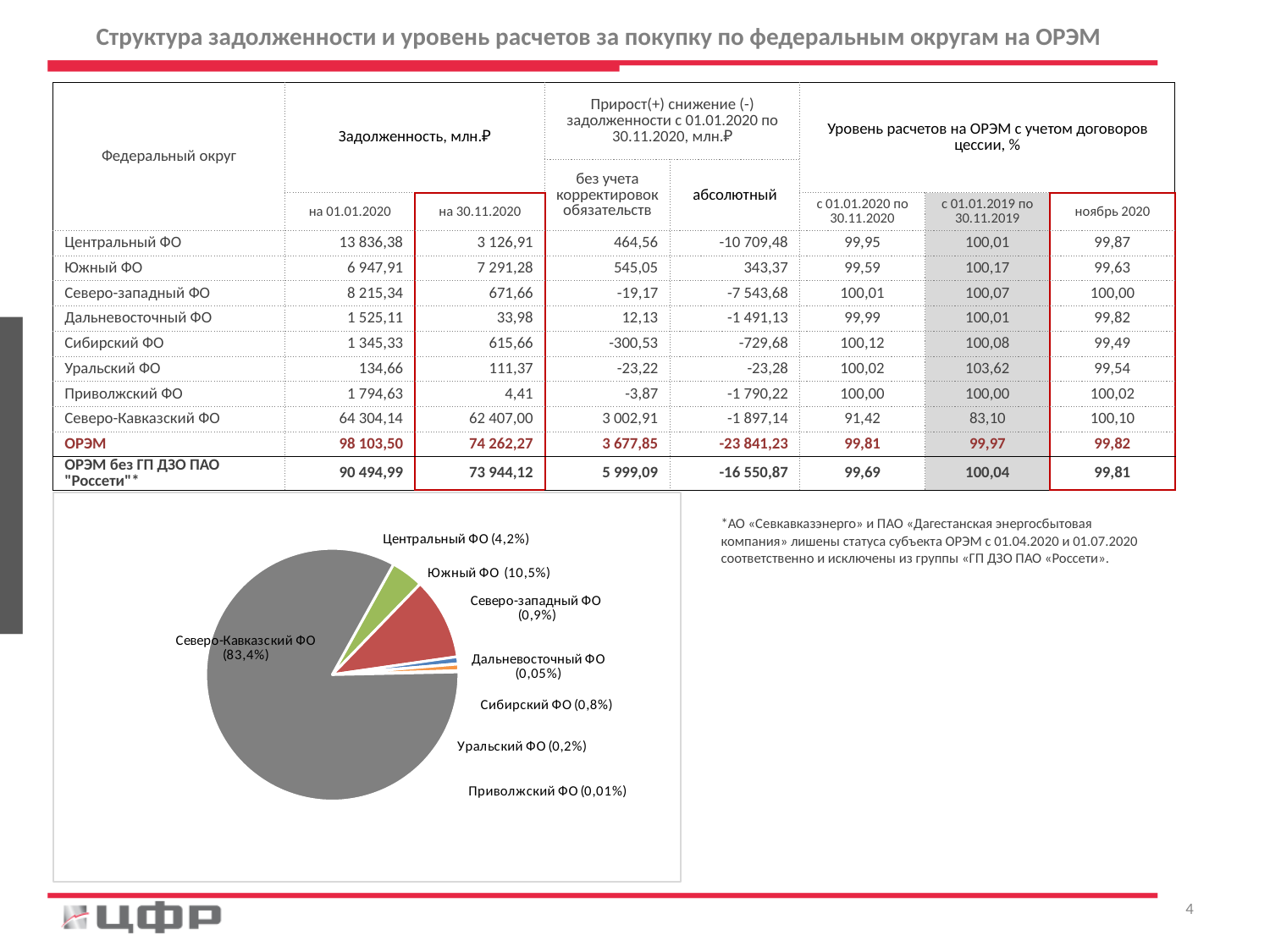
What kind of chart is shown on the slide? pie chart What share of the pie does Центральный ФО have? 4,2% Which has a larger share in the pie chart, Сибирский ФО or Уральский ФО? Сибирский ФО What is the difference in share between Южный ФО and Центральный ФО in the pie chart? 6,3% What share of the pie does Южный ФО have? 10,5% Which slice of the pie chart is the largest? Северо-Кавказский ФО What colour is the Северо-Кавказский ФО slice in the pie chart? grey What share of the pie does Приволжский ФО have? 0,01% Which slice of the pie chart is the smallest? Приволжский ФО How many slices does the pie chart have? 8